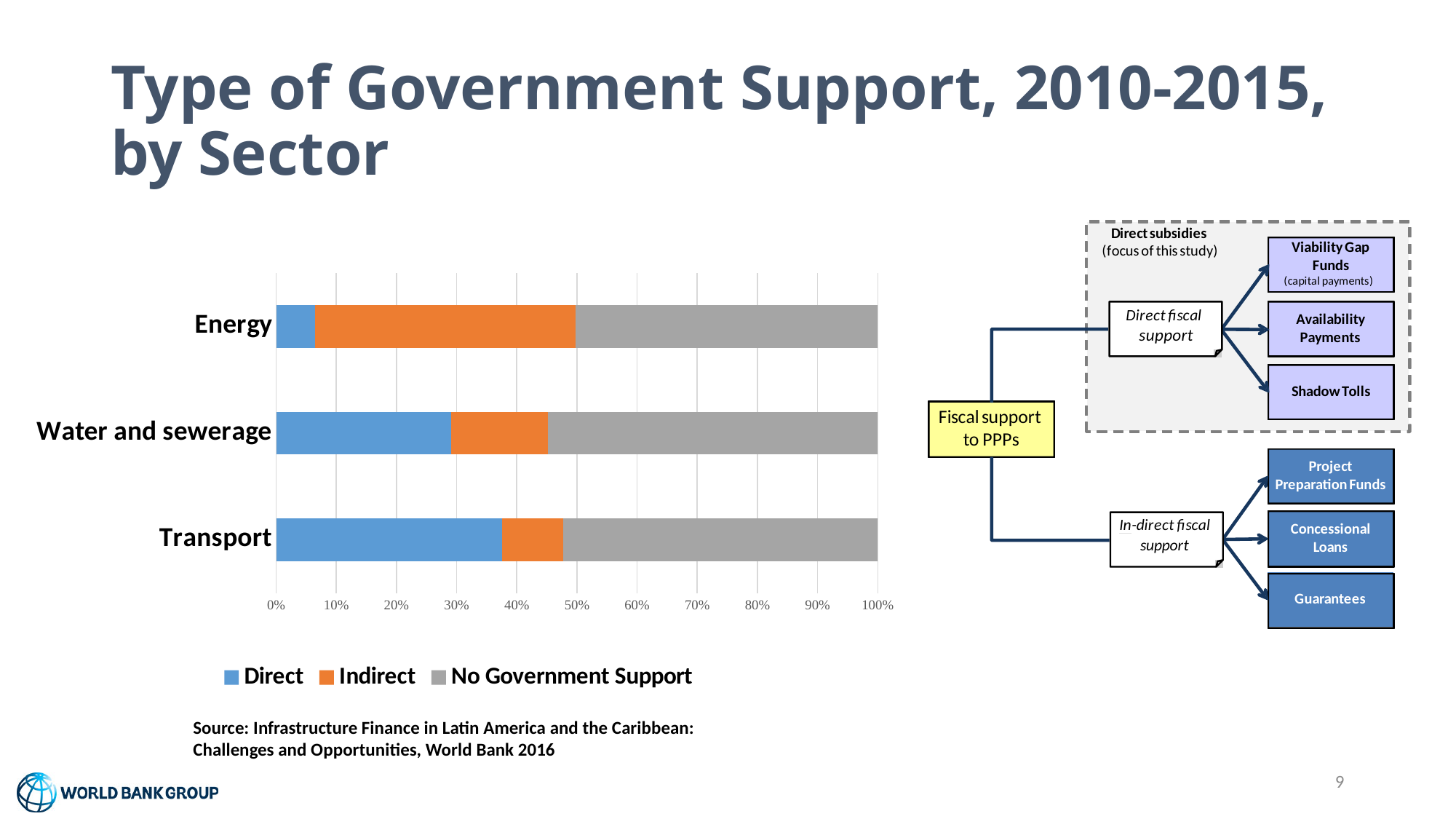
What kind of chart is shown on the slide? Stacked bar chart How many series does the chart legend list? 3 Is the Direct support share for Water and sewerage greater or less than 20%? greater What are the three legend entries of the chart? Direct, Indirect, No Government Support How many sectors are shown on the chart? 3 What is the total of the stacked bar for Transport? 100% Is the Direct support share for Energy greater or less than 10%? less Which sector has the largest Indirect support share? Energy Which is larger: the Indirect support share for Energy or for Transport? Energy Is the Direct support share for Transport greater or less than 30%? greater Which sector has the largest Direct support share? Transport Which sector has the smallest Direct support share? Energy